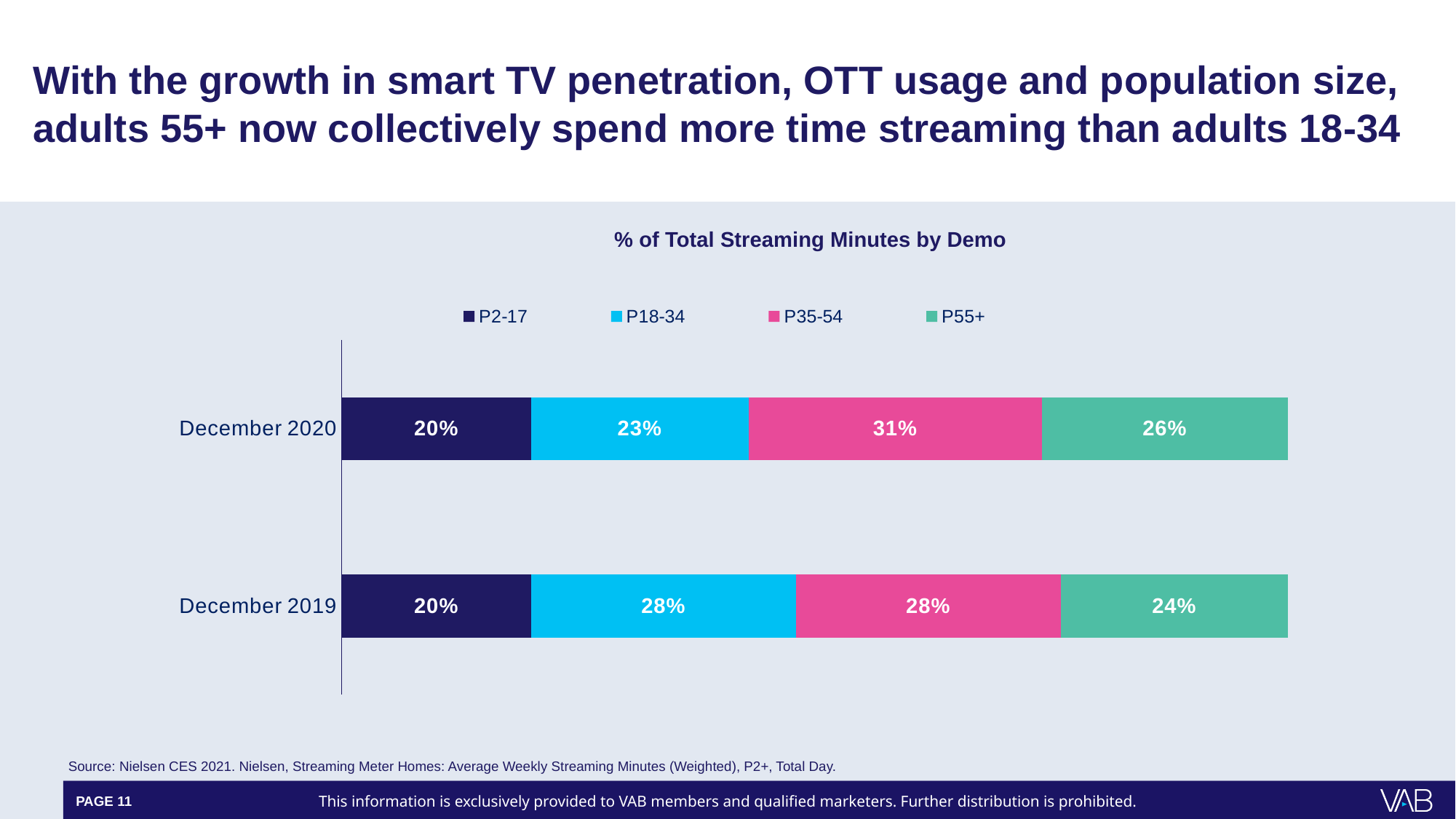
Which is larger in December 2020, the P55+ value or the P18-34 value? P55+ Which demo has the highest share of total streaming minutes in December 2020? P35-54 How many categories (time periods) are shown on the chart? 2 What is the value for P35-54 in December 2020? 31% What is the value for P55+ in December 2019? 24% What kind of chart is shown on the slide? Stacked bar chart What is the value for P18-34 in December 2020? 23% How many series does the legend list? 4 What is the total of the December 2019 stacked bar? 100% What is the difference between the P18-34 values for December 2019 and December 2020? 5% Which demo has the lowest share of total streaming minutes in December 2020? P2-17 What is the title of the chart? % of Total Streaming Minutes by Demo